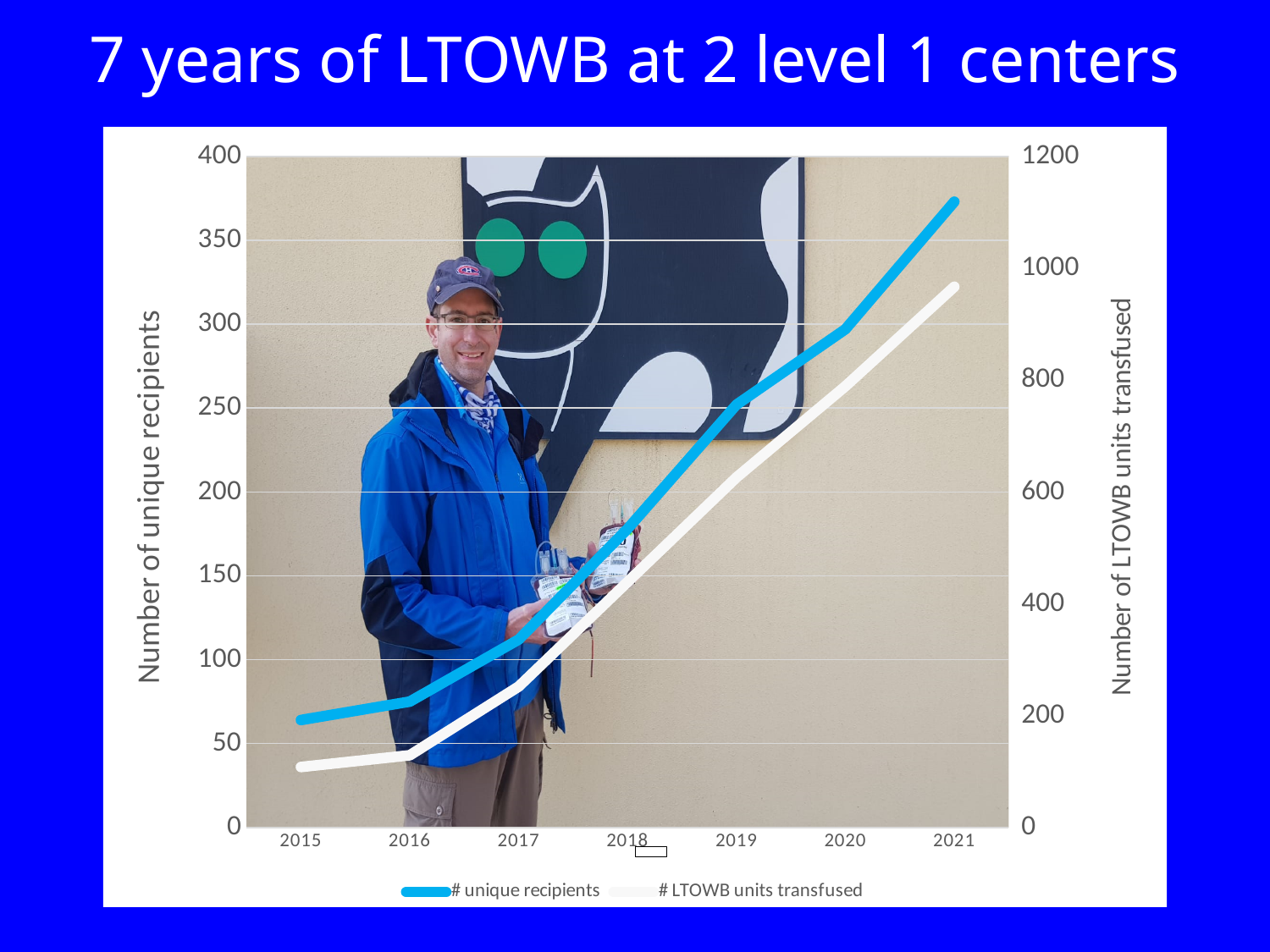
Is the value for # unique recipients in 2021 greater or less than 350 on the left axis? greater Do the values for # unique recipients rise or fall from 2015 to 2021? rise How many years are plotted along the x axis? 7 How many series does the legend list? 2 What is the title of the right-hand vertical axis? Number of LTOWB units transfused In which year is the number of LTOWB units transfused highest? 2021 In which year is the number of unique recipients lowest? 2015 Is the value for # LTOWB units transfused in 2021 greater or less than 1000 on the right axis? less What kind of chart is shown on the slide? line chart Which year has the larger number of unique recipients, 2016 or 2020? 2020 Is the value for # LTOWB units transfused in 2016 greater or less than 200 on the right axis? less